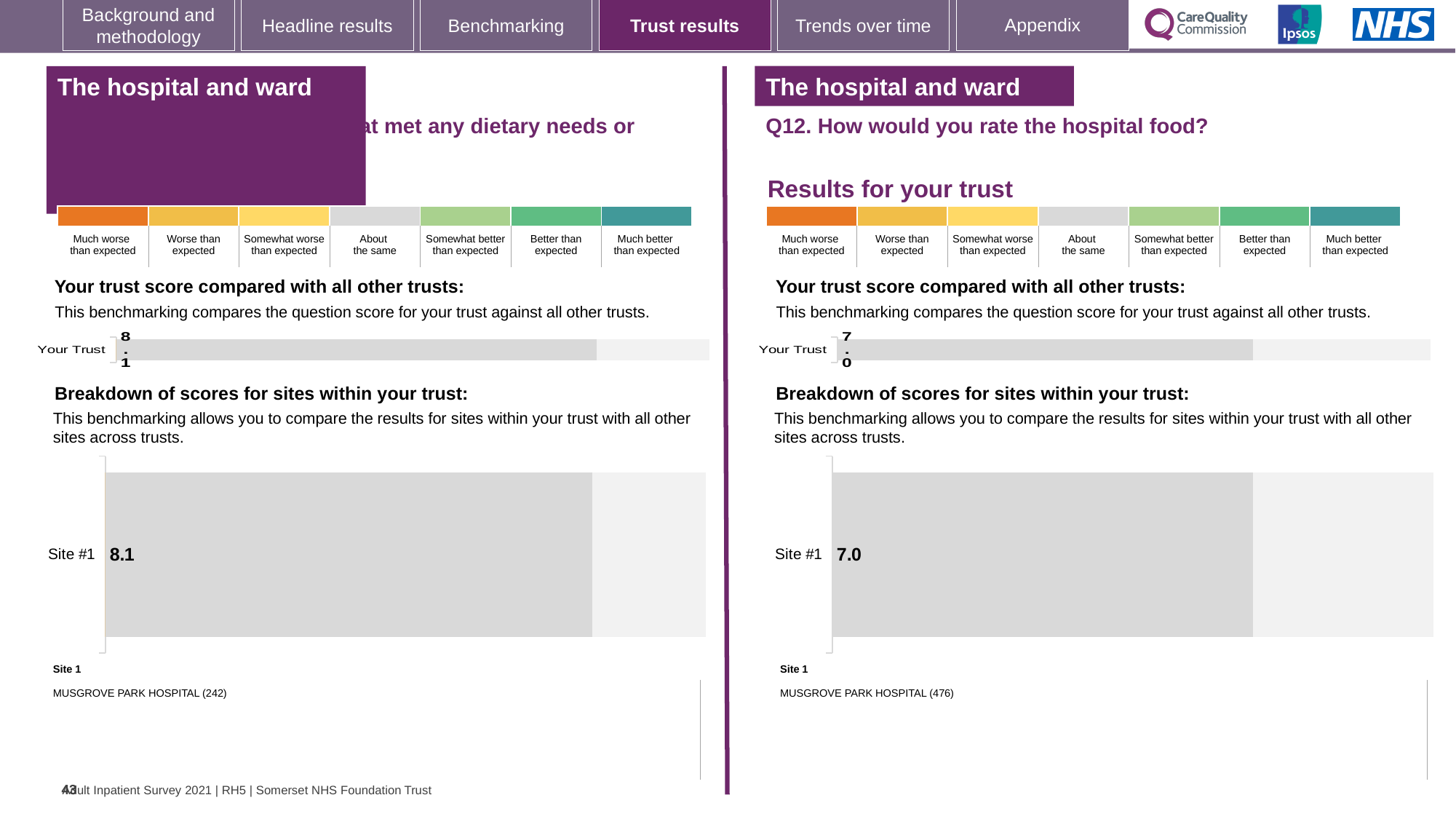
In the left-hand panel, what is the score shown for Your Trust? 8.1 In the right-hand panel (Q12, hospital food), what score is shown for Site #1 in the breakdown of scores for sites? 7.0 In the left-hand panel, what score is shown for Site #1 in the breakdown of scores for sites? 8.1 In the right-hand panel (Q12), how many sites are shown in the breakdown of scores for sites within your trust? 1 In the right-hand panel (Q12, hospital food), what is the score shown for Your Trust? 7.0 What kind of chart is used to show the Your Trust score in each panel? Bar chart In the right-hand panel (Q12), is the Your Trust score greater or less than the Site #1 score? Neither, they are equal (7.0) In the right-hand panel (Q12), which hospital is listed as Site 1? MUSGROVE PARK HOSPITAL (476) Which Site #1 score is larger: the one in the left-hand panel or the one in the right-hand panel (Q12)? Left-hand panel (8.1) What is the difference between the Your Trust score in the left-hand panel and the Your Trust score in the right-hand panel (Q12)? 1.1 How many categories does the colour scale above each chart show, from 'Much worse than expected' to 'Much better than expected'? 7